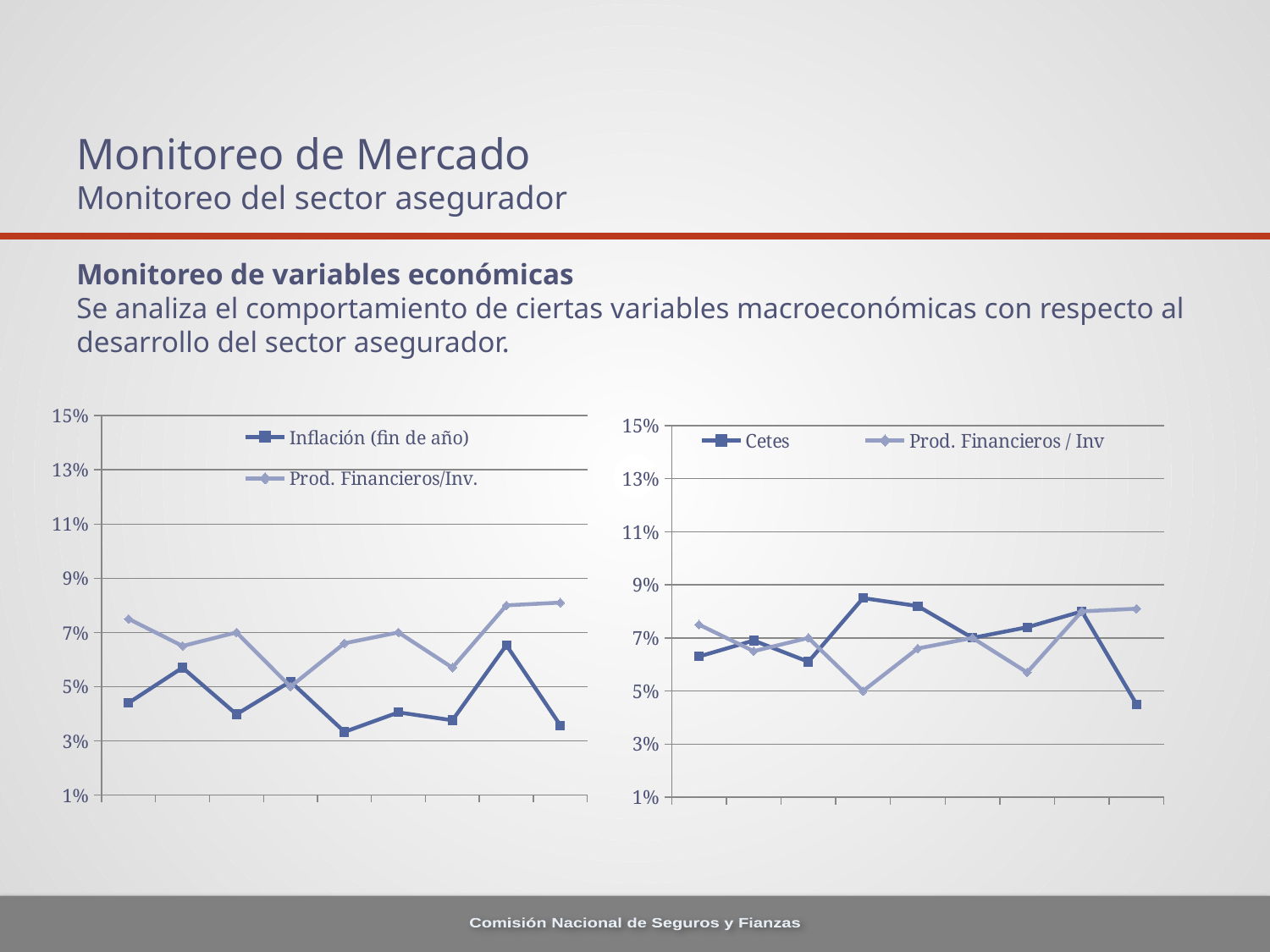
In the right chart, is the last value of Cetes greater or less than 5%? less How many series does the legend of the left chart list? 2 In the right chart, is the highest value of Cetes greater or less than 7%? greater In the left chart, which series is named alongside Prod. Financieros/Inv. in the legend? Inflación (fin de año) How many series does the legend of the right chart list? 2 In the left chart, is the first value of Inflación (fin de año) greater or less than 5%? less What is the highest value shown on the vertical axis of the right chart? 15% What kind of chart is the right chart on the slide? line chart In the left chart, how many data points does the Inflación (fin de año) series have? 9 In the right chart, how many data points does the Cetes series have? 9 What kind of chart is the left chart on the slide? line chart